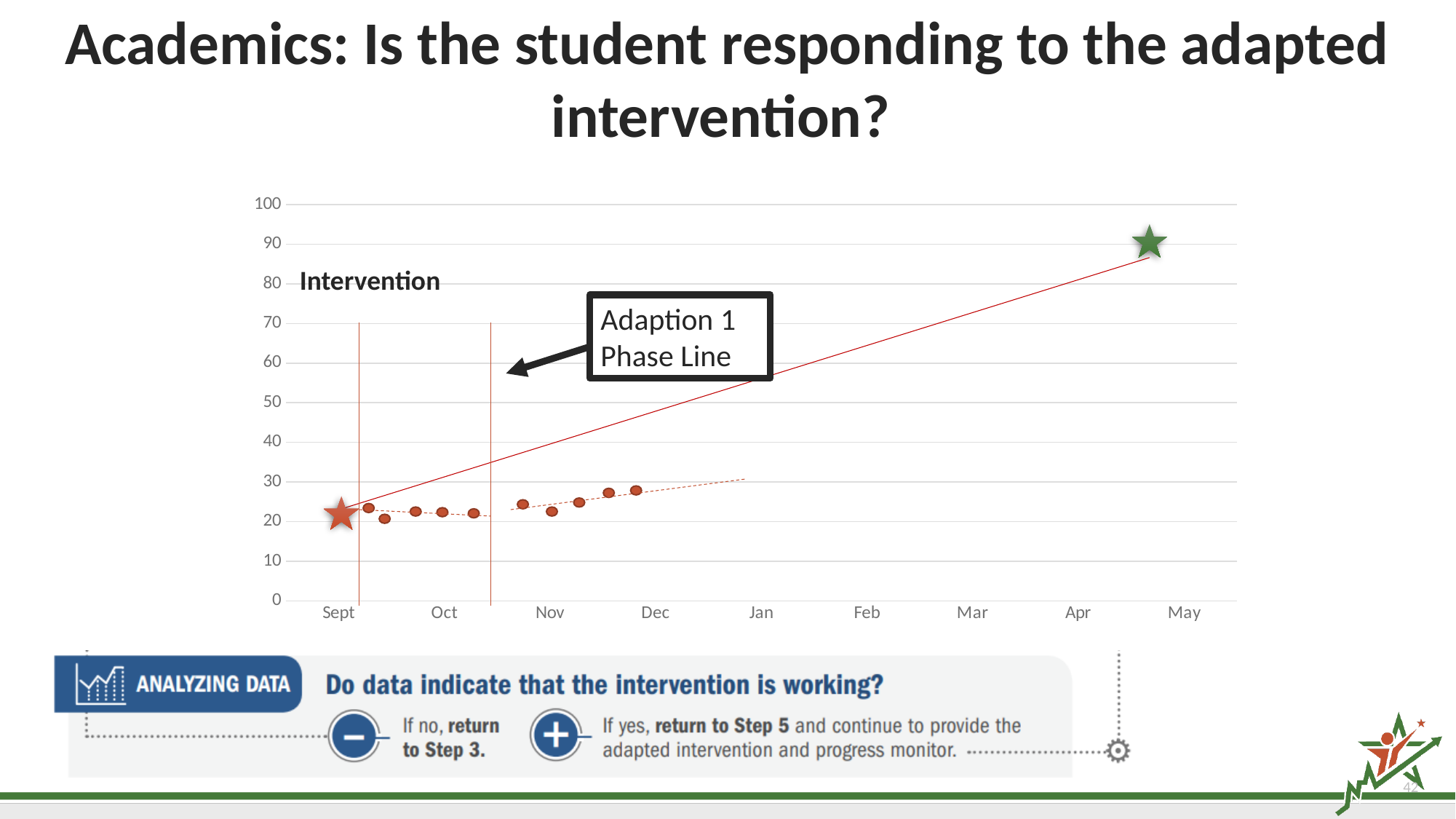
What is the highest value shown on the y axis of the chart? 100 Is the last plotted data point (near Dec) greater or less than the green star value near May? less Is the value marked by the green star near May greater or less than 80? greater Do the plotted data points after the Adaption 1 Phase Line rise or fall as the months progress? rise How many data points (red dots) are plotted between the Intervention line and the Adaption 1 Phase Line? 5 How many data points (red dots) are plotted to the right of the Adaption 1 Phase Line? 5 What does the callout box with the arrow label the vertical orange line as? Adaption 1 Phase Line Are all of the plotted data points (the red dots) greater or less than 40? less What is the first month shown on the x axis of the chart? Sept Is the value marked by the red star at Sept greater or less than 30? less How many month labels are shown along the x axis of the chart? 9 What is the last month shown on the x axis of the chart? May